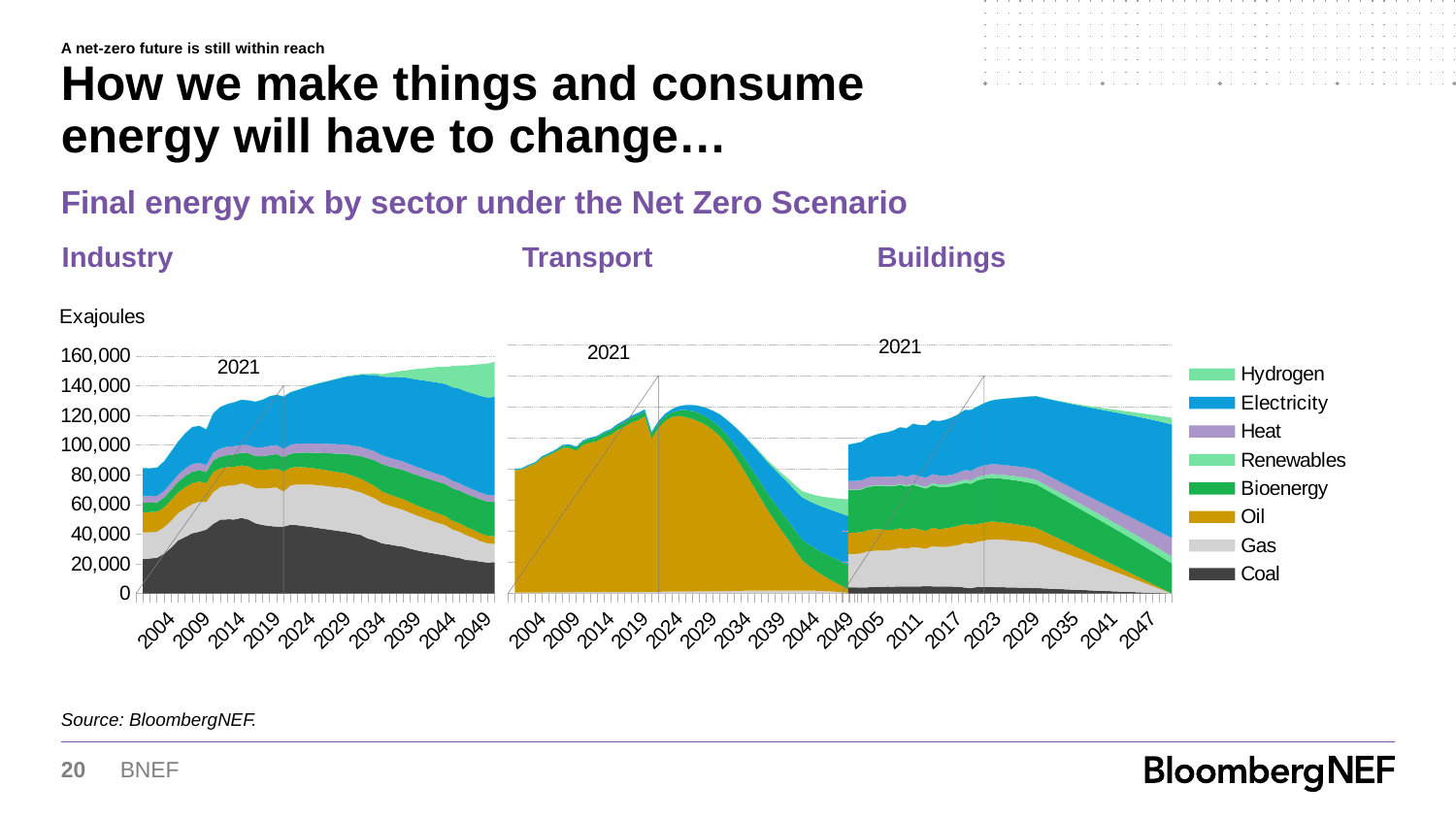
In the Buildings chart, does the Electricity area rise or fall between 2005 and 2029? rise How many series does the legend list? 8 In the Industry chart, is the Coal value in 2049 greater or less than 40,000? less Which sector does the middle chart show? Transport What kind of chart is the Industry chart? stacked area chart In the Industry chart, does the Coal area rise or fall between 2014 and 2049? fall In the Transport chart, does the Oil area rise or fall between 2024 and 2049? fall In the Industry chart, is the total final energy in 2004 greater or less than 100,000? less What unit is shown on the y axis of the charts? Exajoules In the Industry chart, is the total final energy in 2049 greater or less than 140,000? greater In the Transport chart, which series makes up most of the total in 2021? Oil How many charts are shown on the slide? 3